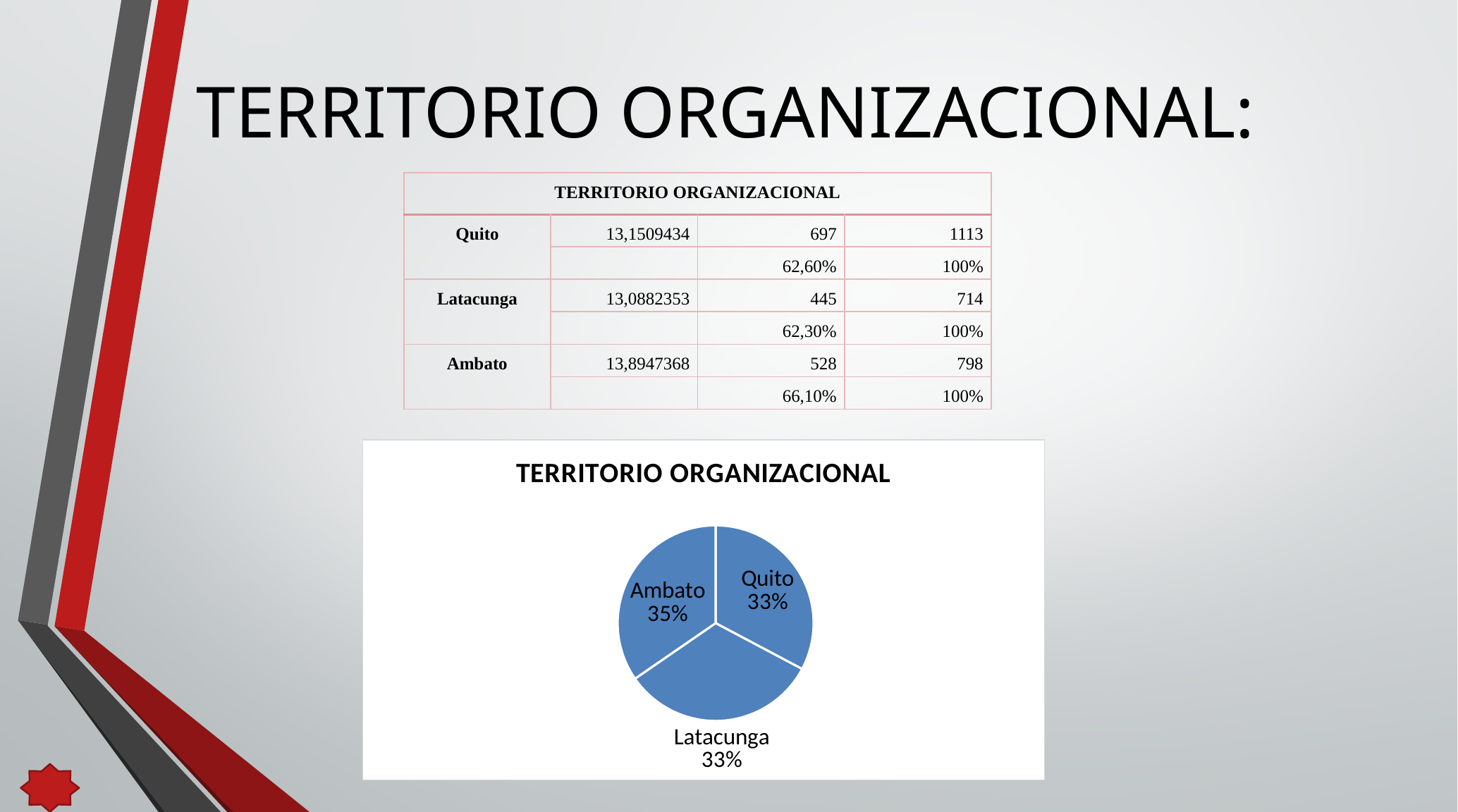
What colour are the slices of the pie chart? blue Which is larger in the pie chart, Ambato or Latacunga? Ambato By how many percentage points does Ambato's share exceed Latacunga's share? 2 What share of the pie does Quito represent? 33% What share of the pie does Ambato represent? 35% By how many percentage points does Ambato's share exceed Quito's share? 2 What kind of chart is shown on the slide? pie chart What share of the pie does Latacunga represent? 33% How many slices does the pie chart have? 3 Which is larger in the pie chart, Ambato or Quito? Ambato Which slice of the pie chart is the largest? Ambato What is the title of the chart? TERRITORIO ORGANIZACIONAL